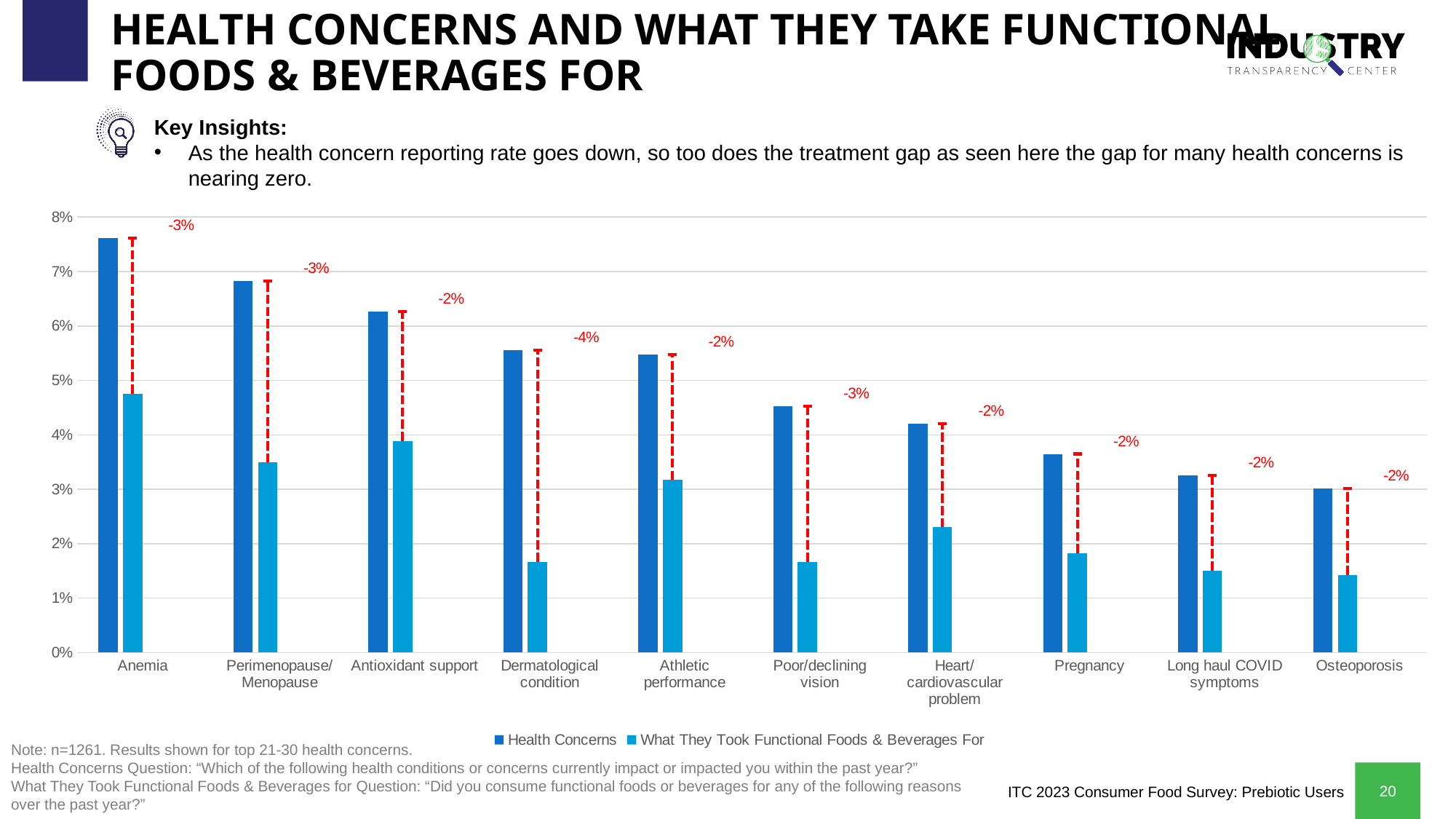
Is the Health Concerns value for Anemia greater or less than 7%? greater How many series does the chart legend list? 2 Which category has the highest Health Concerns value? Anemia What kind of chart is shown on the slide? Bar chart Do the Health Concerns values rise or fall moving from left to right along the x axis? Fall Is the What They Took Functional Foods & Beverages For value for Dermatological condition greater or less than 2%? less What are the two series names listed in the chart legend? Health Concerns; What They Took Functional Foods & Beverages For Which category has the lowest Health Concerns value? Osteoporosis How many health concern categories are shown on the x axis of the chart? 10 What gap label is printed above the Anemia bars? -3% What gap label is printed above the Dermatological condition bars? -4% Which is larger, the What They Took Functional Foods & Beverages For value for Anemia or for Osteoporosis? Anemia